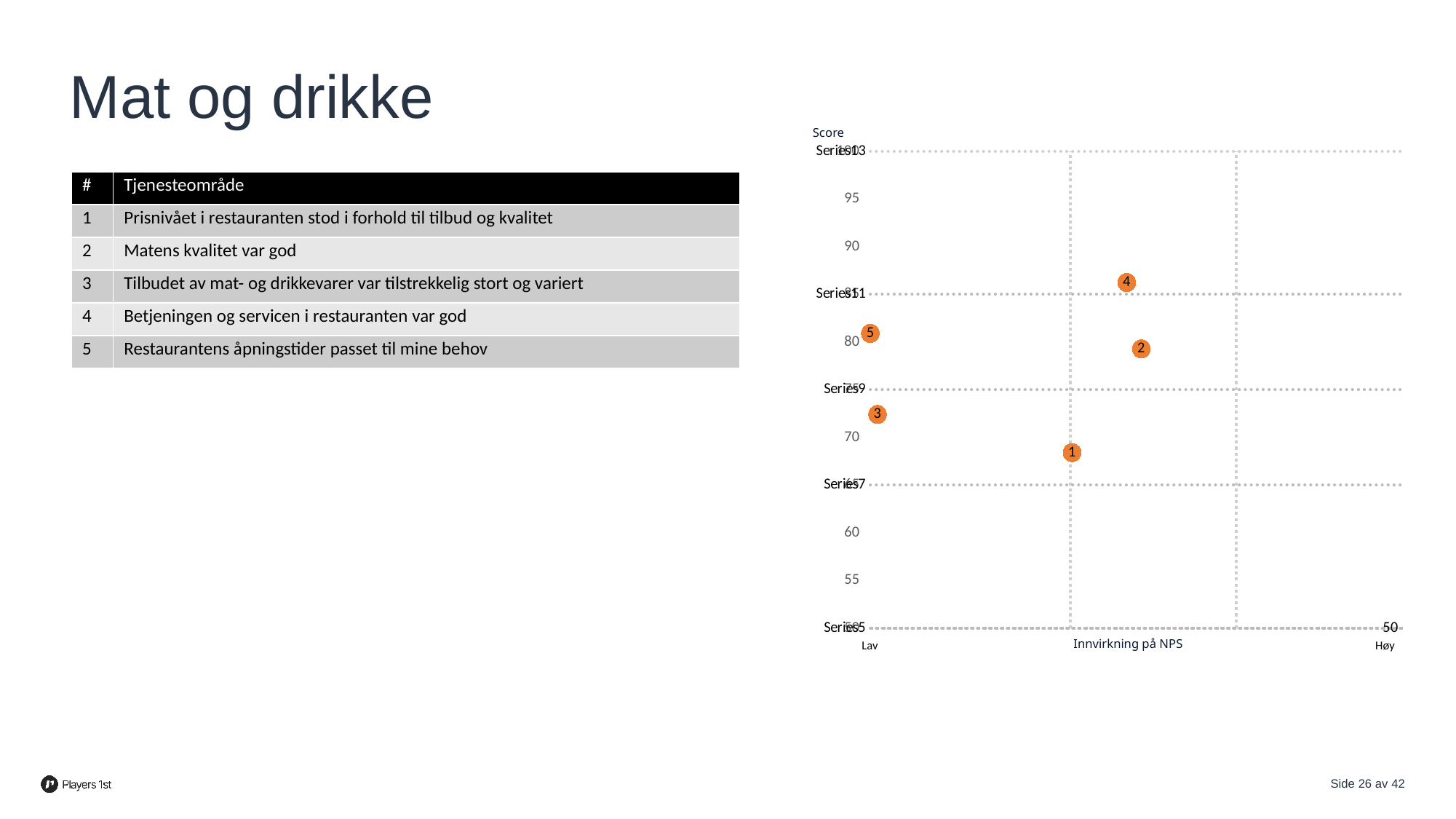
What kind of chart is shown on the slide? scatter chart Is the Score for point 5 greater or less than 75? greater Is the Score for point 2 greater or less than 85? less Which numbered point has the highest Score on the chart? 4 Is the Score for point 4 greater or less than 85? greater What is the title of the vertical axis of the chart? Score How many data points are plotted on the chart? 5 Which numbered point has the lowest Score on the chart? 1 What is the title of the horizontal axis of the chart? Innvirkning på NPS Which has the higher Score, point 3 or point 1? 3